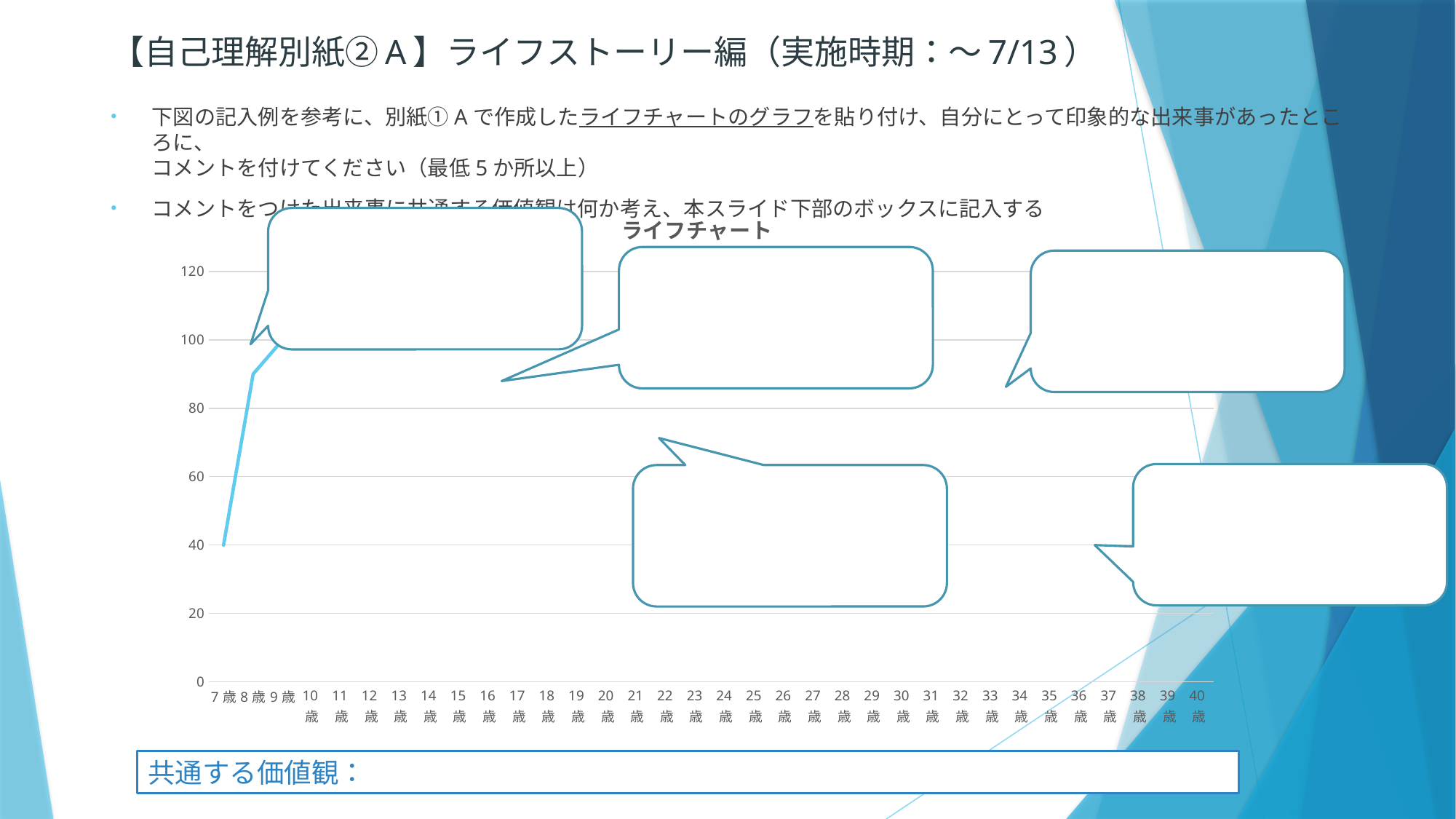
What is the title of the chart? ライフチャート What is the first category on the x axis? 7歳 How many age categories are shown on the x axis? 34 What kind of chart is shown on the slide? line chart What is the value plotted for 7歳? 40 Does the line rise or fall from 7歳 to 8歳? rises What is the highest tick value shown on the y axis? 120 Is the value for 8歳 greater or less than 80? greater Which is larger, the value for 7歳 or the value for 8歳? 8歳 Is the value for 7歳 greater or less than 60? less